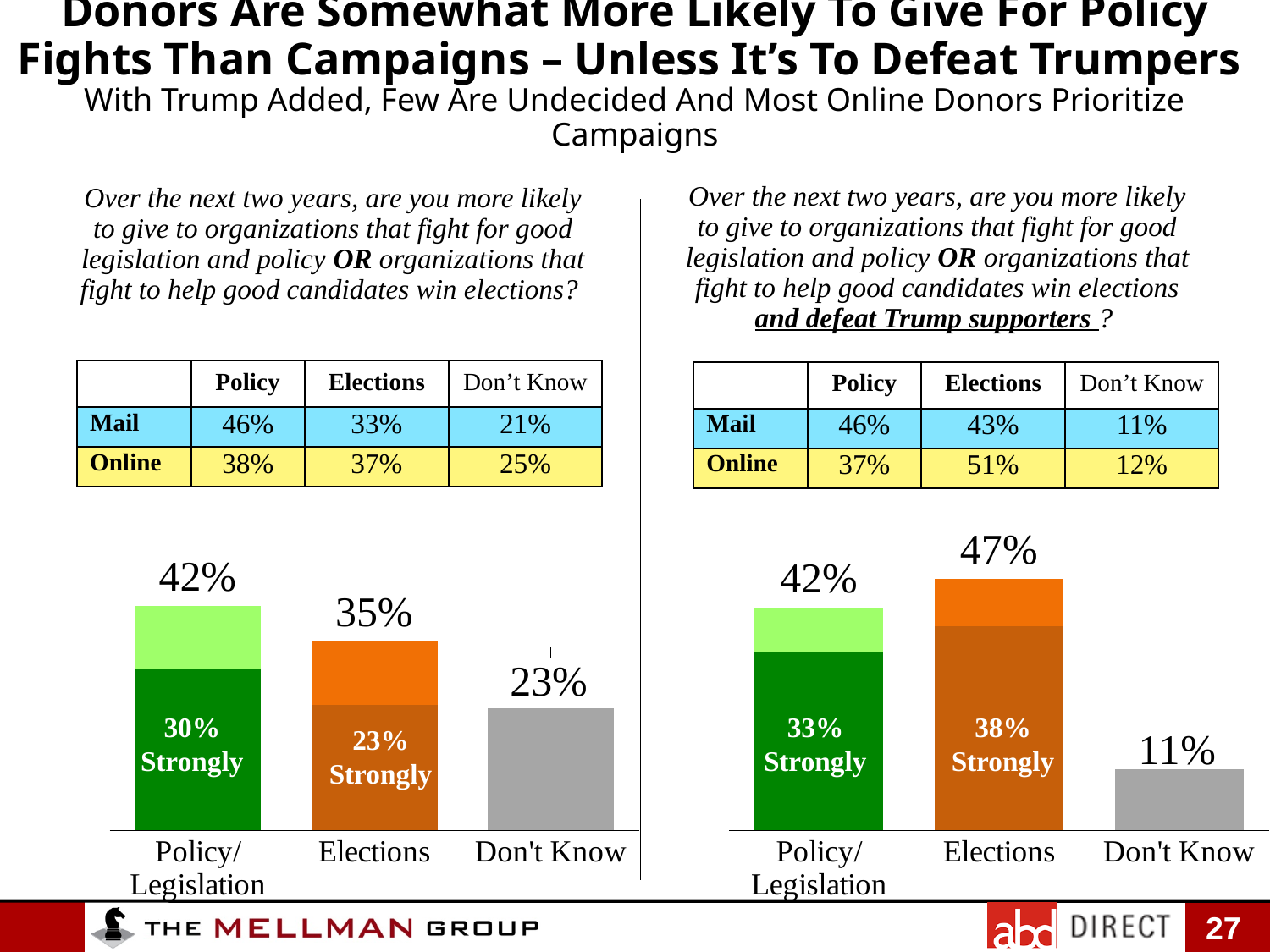
In the right chart, what is the difference between the Elections total (47%) and the Don't Know value (11%)? 36% In the left chart, what is the difference between the Policy/Legislation total (42%) and the Elections total (35%)? 7% What type of chart is the right chart? Bar chart In the left chart, which category has the lowest value? Don't Know In the left chart, which is larger: the Policy/Legislation total or the Elections total? Policy/Legislation How many categories are shown on the x axis of the left chart? 3 In the left chart, what is the 'Strongly' portion for Elections? 23% In the right chart, which category has the highest value? Elections In the right chart, what is the 'Strongly' portion for Policy/Legislation? 33% In the right chart, what is the value shown for Don't Know? 11% In the left chart, what is the total value shown for Policy/Legislation? 42% In the right chart, which is larger: the Elections total or the Policy/Legislation total? Elections